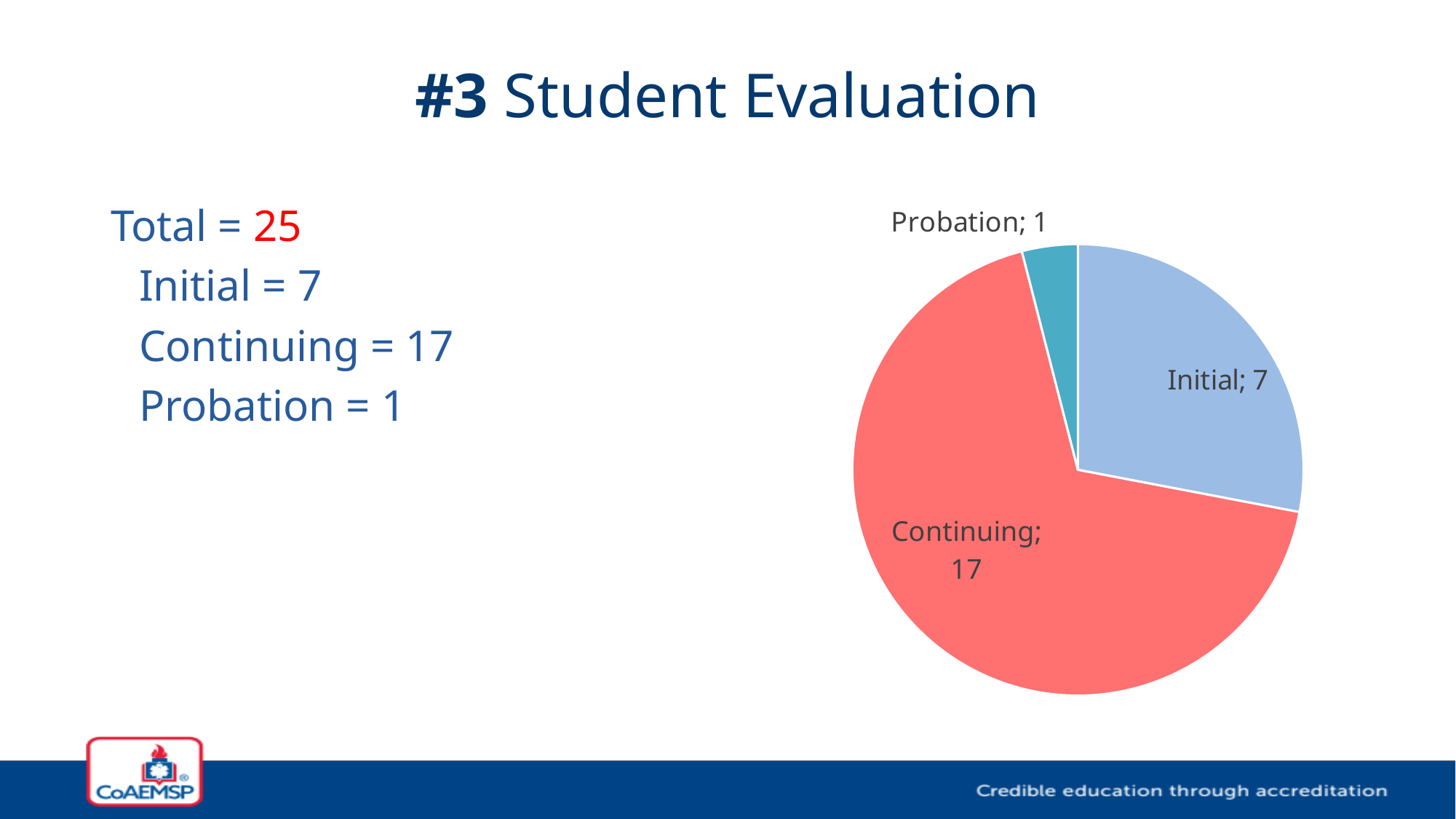
What is the value for Probation in the pie chart? 1 What is the total of all slices in the pie chart? 25 Which category has the largest slice in the pie chart? Continuing Which is larger, Initial or Probation? Initial Which category has the smallest slice in the pie chart? Probation What is the value for Initial in the pie chart? 7 What share of the pie does Continuing represent? 68% What is the value for Continuing in the pie chart? 17 What is the difference between the Continuing and Initial values? 10 What type of chart is shown on the slide? pie chart What colour is the Continuing slice? red How many categories are shown in the pie chart? 3